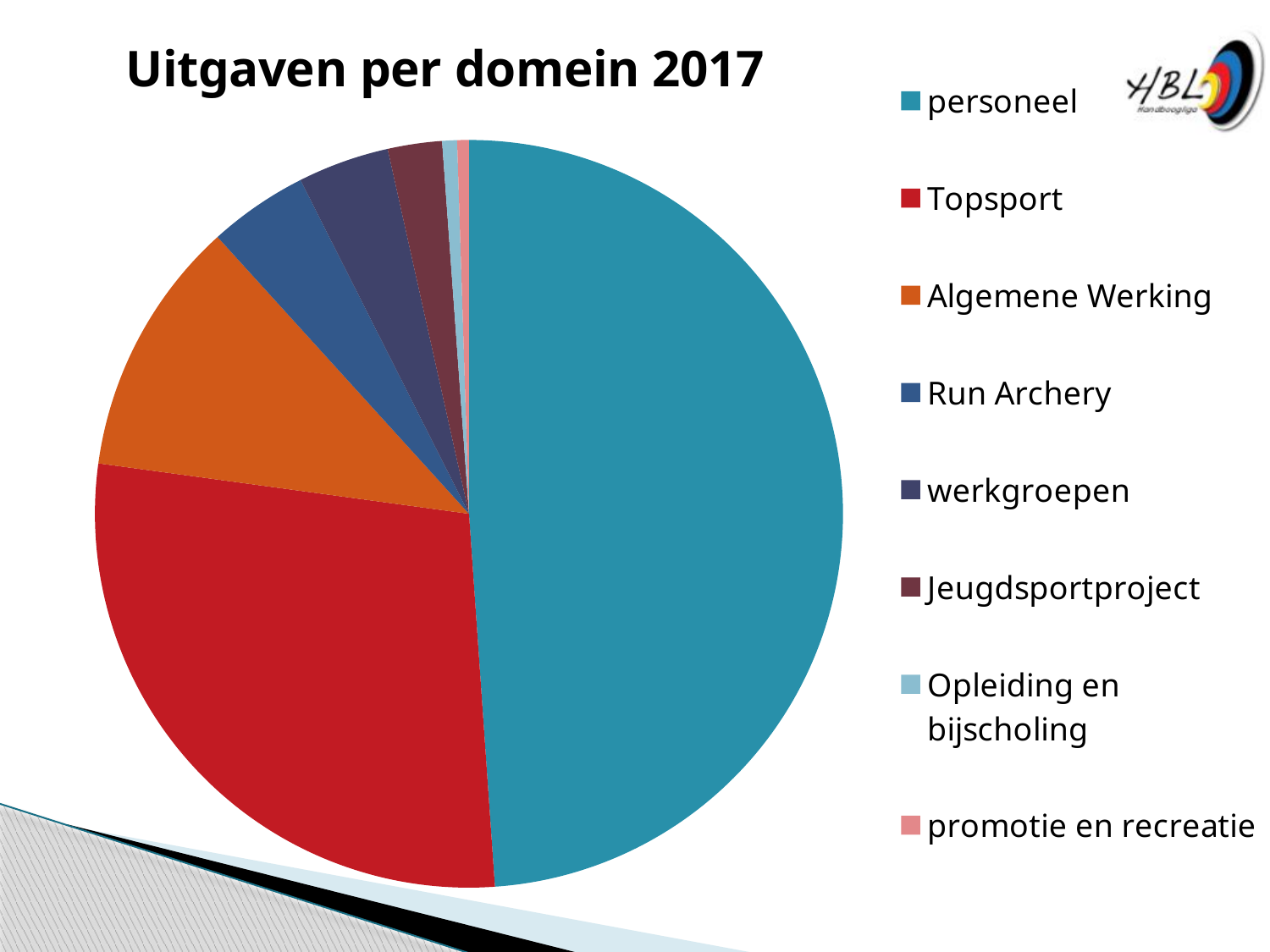
What kind of chart is shown on the slide? pie chart Which slice is larger, werkgroepen or Jeugdsportproject? werkgroepen Which category is the second largest slice of the pie? Topsport What is the title of the chart? Uitgaven per domein 2017 Which slice is larger, personeel or Topsport? personeel Which slice is larger, Algemene Werking or Run Archery? Algemene Werking Which category has the largest slice of the pie? personeel How many categories does the legend of the pie chart list? 8 Which colour represents Topsport in the pie chart? red